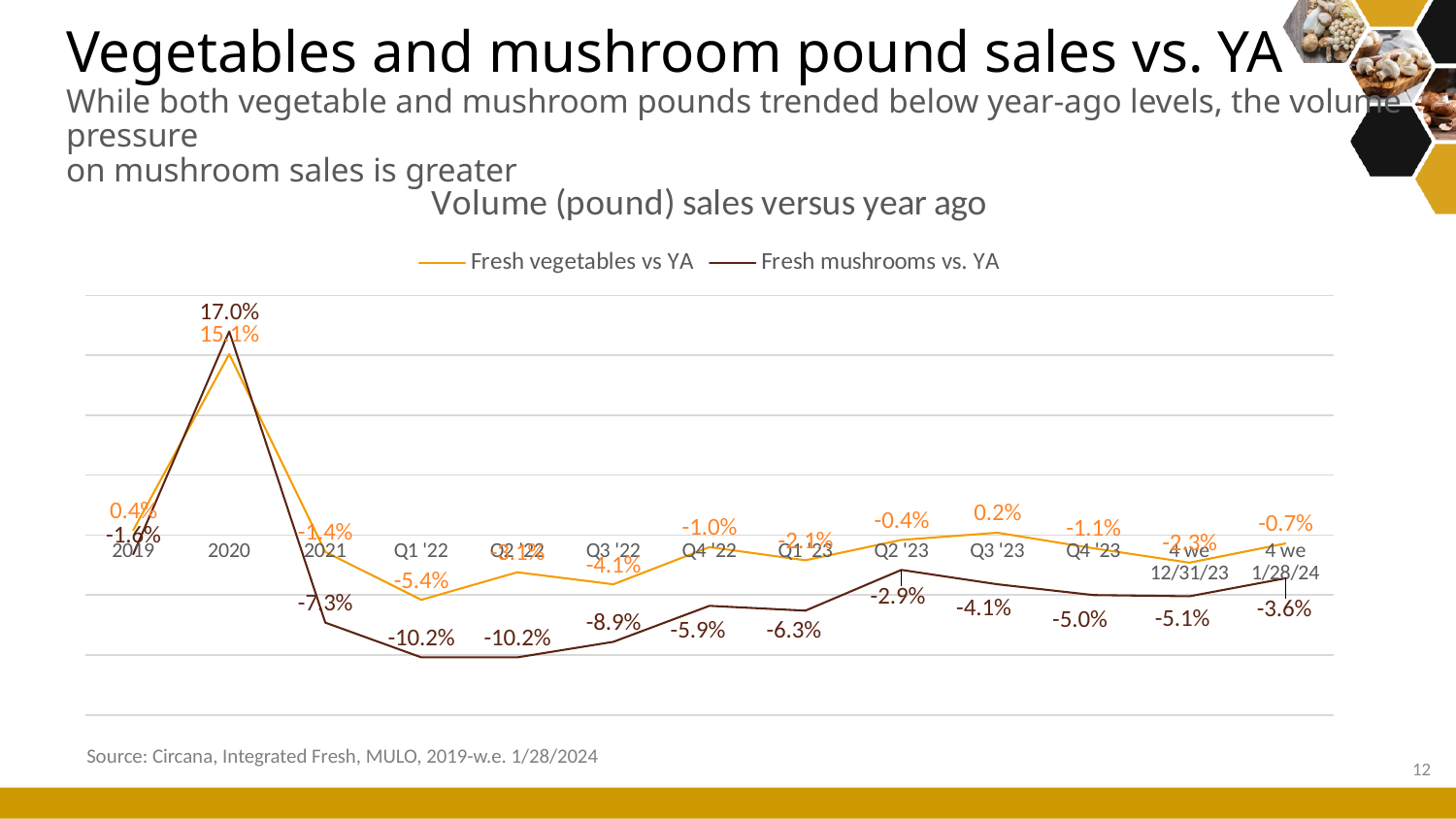
What is the value for Fresh vegetables vs YA in 2020? 15.1% What is the value for Fresh vegetables vs YA in Q3 '23? 0.2% In which period is the Fresh mushrooms vs. YA value highest? 2020 What is the value for Fresh mushrooms vs. YA in 2020? 17.0% What is the value for Fresh mushrooms vs. YA in Q1 '22? -10.2% What type of chart is shown on the slide? line chart What is the value for Fresh mushrooms vs. YA for the 4 weeks ending 1/28/24? -3.6% What is the title of the chart? Volume (pound) sales versus year ago Which series has the higher value in Q4 '22, Fresh vegetables vs YA or Fresh mushrooms vs. YA? Fresh vegetables vs YA What is the difference between the Fresh mushrooms vs. YA and Fresh vegetables vs YA values in 2020? 1.9% How many series does the legend list? 2 In which period is the Fresh vegetables vs YA value lowest? Q1 '22